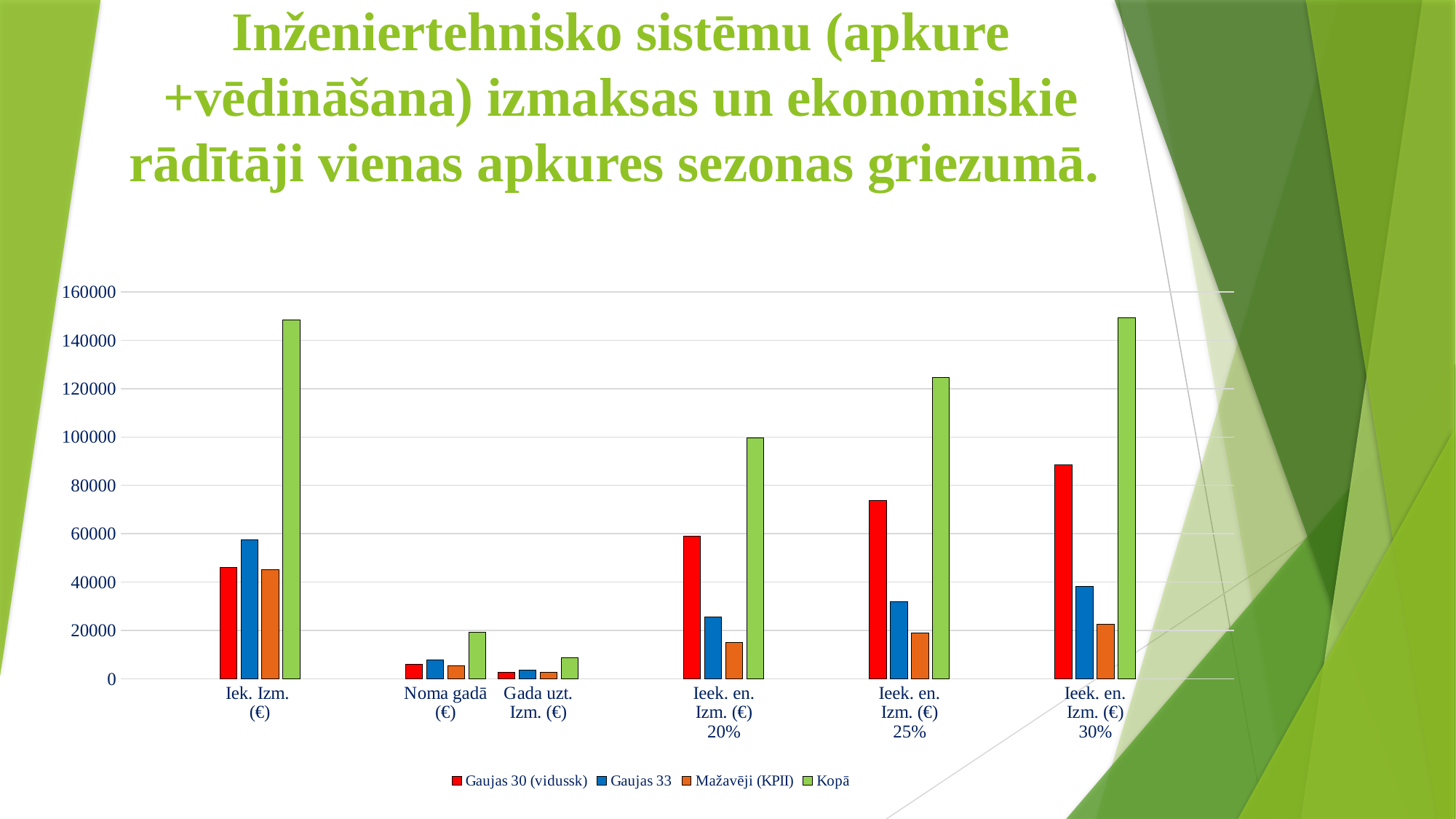
How many categories are shown on the x axis? 6 How many series does the legend list? 4 Does the Kopā value rise or fall from Ieek. en. Izm. (€) 20% to Ieek. en. Izm. (€) 30%? rises Is the Gaujas 30 (vidussk) value for Ieek. en. Izm. (€) 30% greater or less than 80000? greater Is the Mažavēji (KPII) value for Ieek. en. Izm. (€) 20% greater or less than 20000? less In the Ieek. en. Izm. (€) 30% category, which is larger: Gaujas 30 (vidussk) or Gaujas 33? Gaujas 30 (vidussk) Is the Kopā value for Gada uzt. Izm. (€) greater or less than 20000? less Which series has the highest value in the Iek. Izm. (€) category? Kopā What kind of chart is shown on the slide? bar chart For which category is the Kopā value lowest? Gada uzt. Izm. (€)